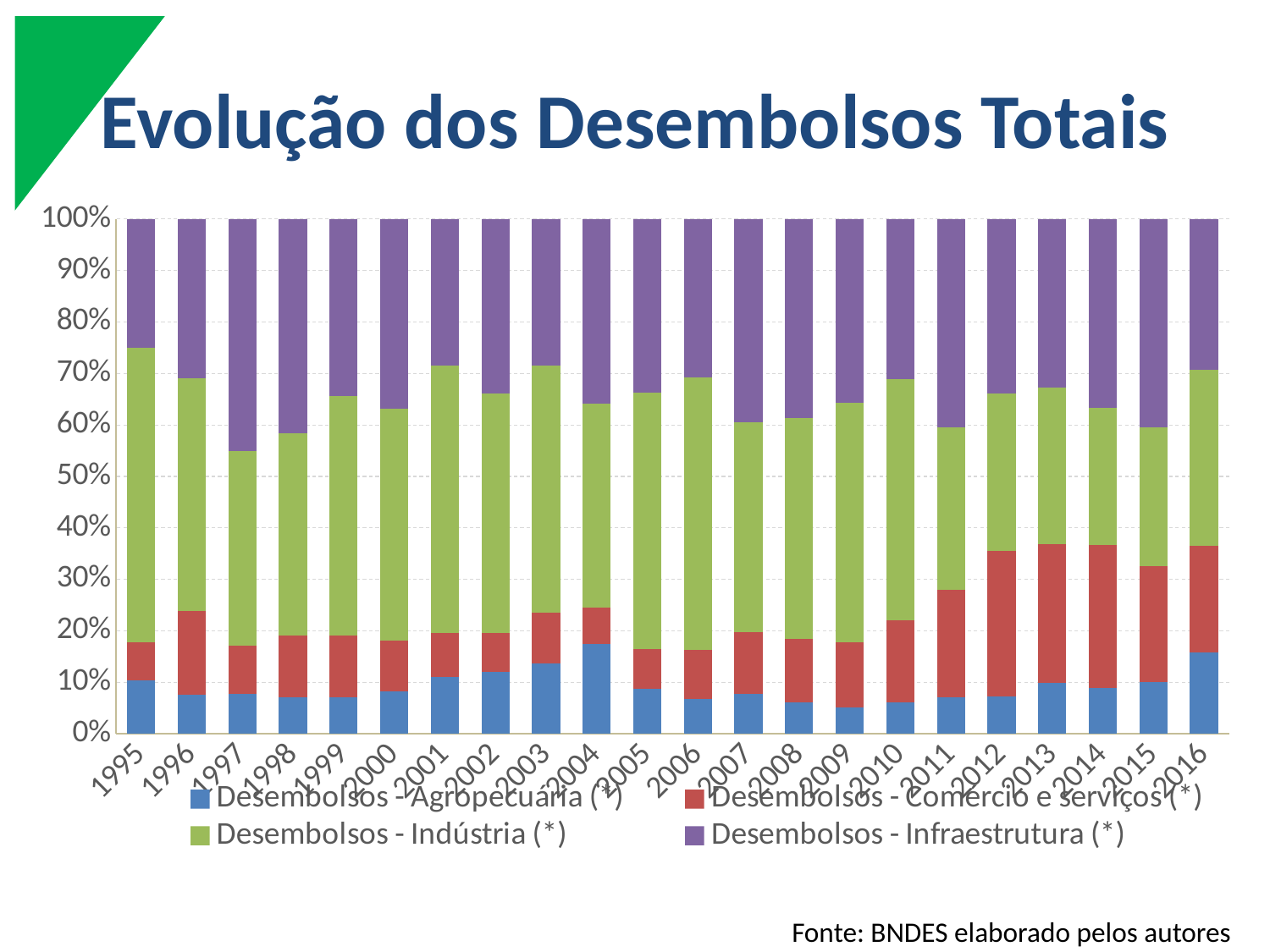
Is the share for Desembolsos - Agropecuária (*) in 2004 greater or less than 10%? greater How many years are shown along the x axis? 22 Which series is shown in purple? Desembolsos - Infraestrutura (*) What do the four segments of each bar add up to? 100% Is the share for Desembolsos - Agropecuária (*) in 2009 greater or less than 10%? less What is the title of the chart? Evolução dos Desembolsos Totais Is the share for Desembolsos - Indústria (*) in 1995 greater or less than 50%? greater Does the share for Desembolsos - Comércio e serviços (*) rise or fall from 2010 to 2013? rise What type of chart is shown on the slide? Stacked bar chart How many series does the legend list? 4 Which year has the larger share for Desembolsos - Indústria (*), 1995 or 2016? 1995